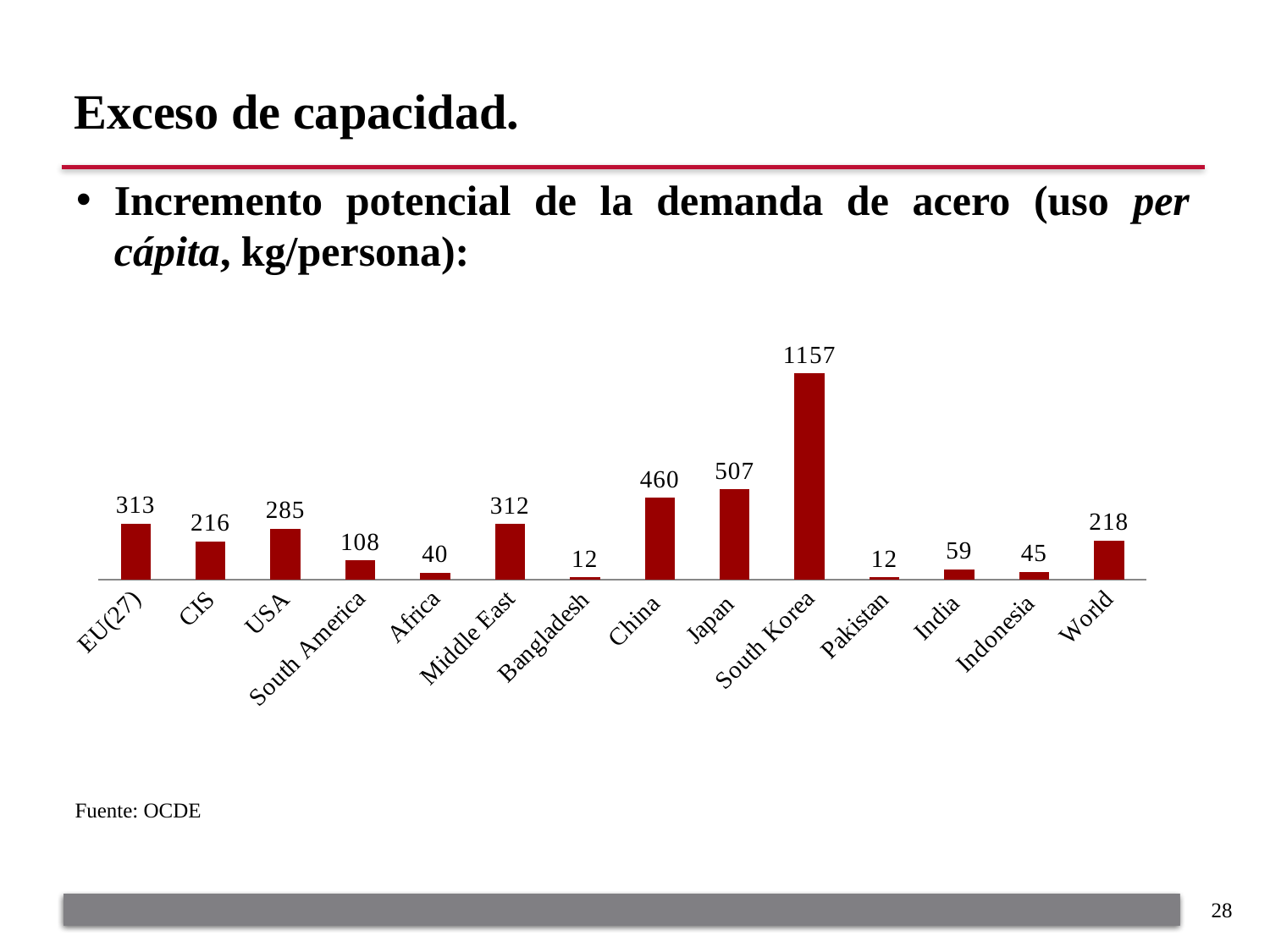
Which is larger, the value for India or the value for Indonesia? India What is the source cited below the chart? OCDE What is the difference between the values for EU(27) and USA? 28 What is the difference between the values for Japan and China? 47 What is the value for China? 460 What kind of chart is shown on the slide? Bar chart What is the value for South Korea? 1157 How many categories are shown on the x axis? 14 Which category has the highest value? South Korea Which is larger, the value for CIS or the value for World? World Which categories share the lowest value? Bangladesh and Pakistan What is the value for World? 218